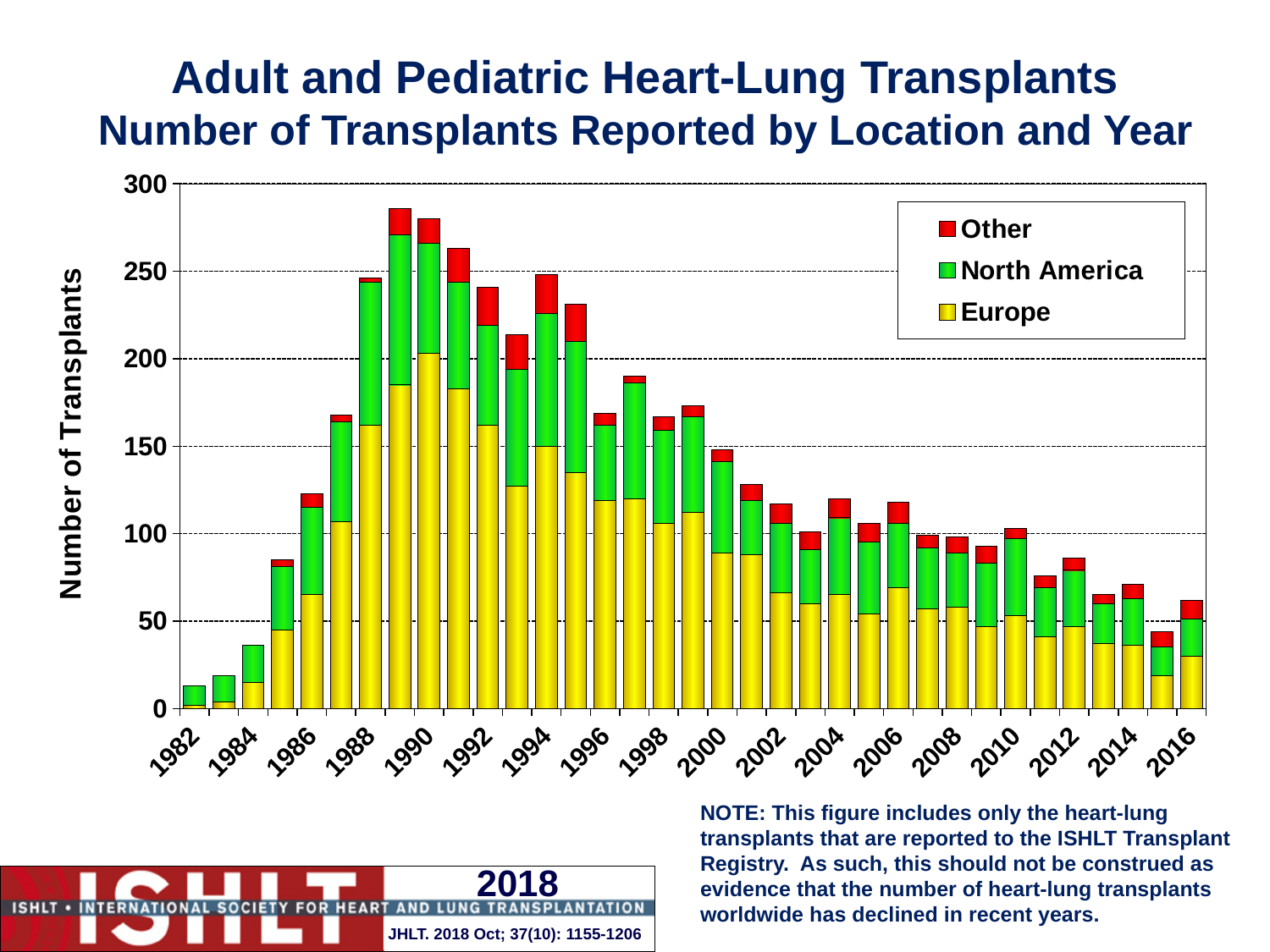
How many series does the legend list? 3 Which year has the larger total number of transplants, 1994 or 2004? 1994 Is the total number of transplants for 2013 greater or less than 100? less What kind of chart is shown on the slide? stacked bar chart Is the total number of transplants for 2016 greater or less than 100? less Which series is shown in red? Other Is the total number of transplants for 1989 greater or less than 250? greater Which series is shown in yellow? Europe Which year has the lowest total number of transplants? 1982 How many years (bars) are plotted on the chart? 35 Do the total numbers of transplants generally rise or fall from 1990 to 2016? fall